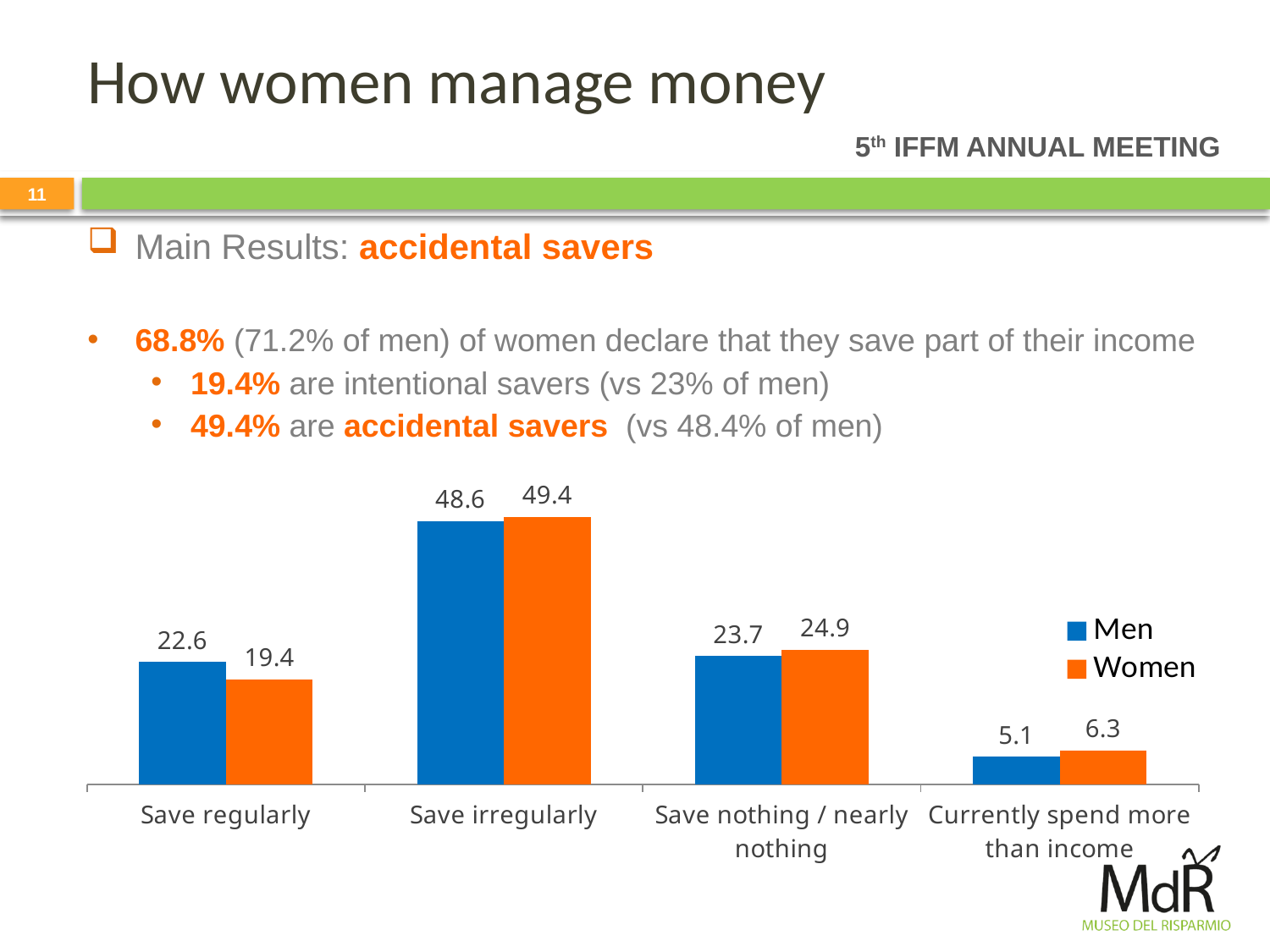
What is the value for Women in the Save irregularly category? 49.4 How many series does the chart legend list? 2 How many categories are shown on the x axis of the chart? 4 Which category has the highest value for Women? Save irregularly Which colour represents Women in the chart? Orange What is the value for Men in the Save nothing / nearly nothing category? 23.7 Which is larger in the Save nothing / nearly nothing category, the value for Men or for Women? Women Which category has the lowest value for Men? Currently spend more than income What is the value for Women in the Currently spend more than income category? 6.3 What is the value for Men in the Save regularly category? 22.6 What is the difference between the Men and Women values in the Save regularly category? 3.2 What kind of chart is shown on the slide? Bar chart